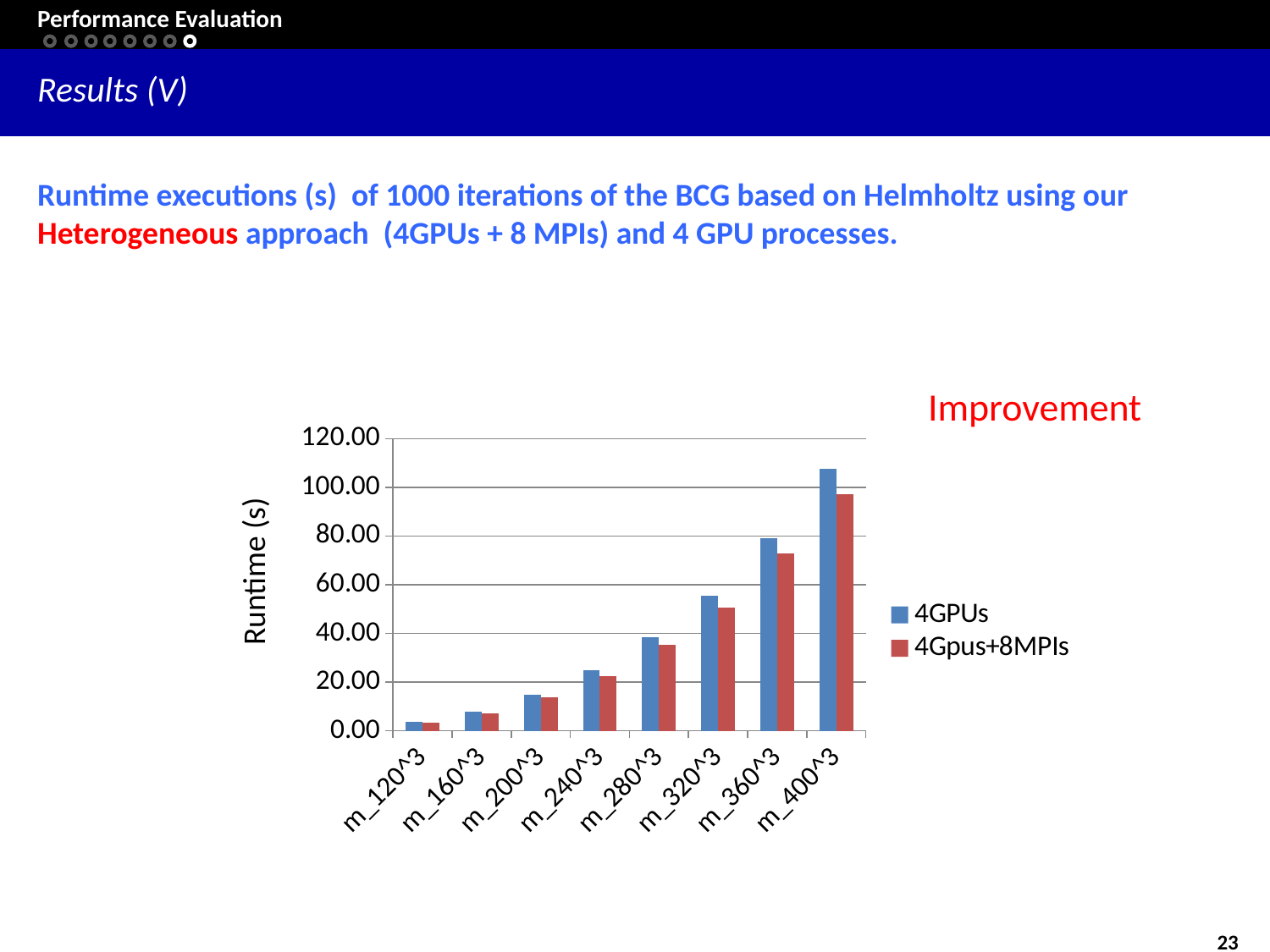
How many series does the legend list? 2 Is the 4GPUs value for m_400^3 greater or less than 100.00? greater Which category has the highest runtime for the 4GPUs series? m_400^3 How many categories are shown on the x axis? 8 What kind of chart is shown on the slide? bar chart At m_400^3, which series has the larger runtime, 4GPUs or 4Gpus+8MPIs? 4GPUs Do the runtime values rise or fall as the problem size increases along the x axis? rise What is the label of the vertical axis? Runtime (s) Is the 4Gpus+8MPIs value for m_360^3 greater or less than 80.00? less Is the 4GPUs value for m_240^3 greater or less than 20.00? greater Which category has the lowest runtime for the 4Gpus+8MPIs series? m_120^3